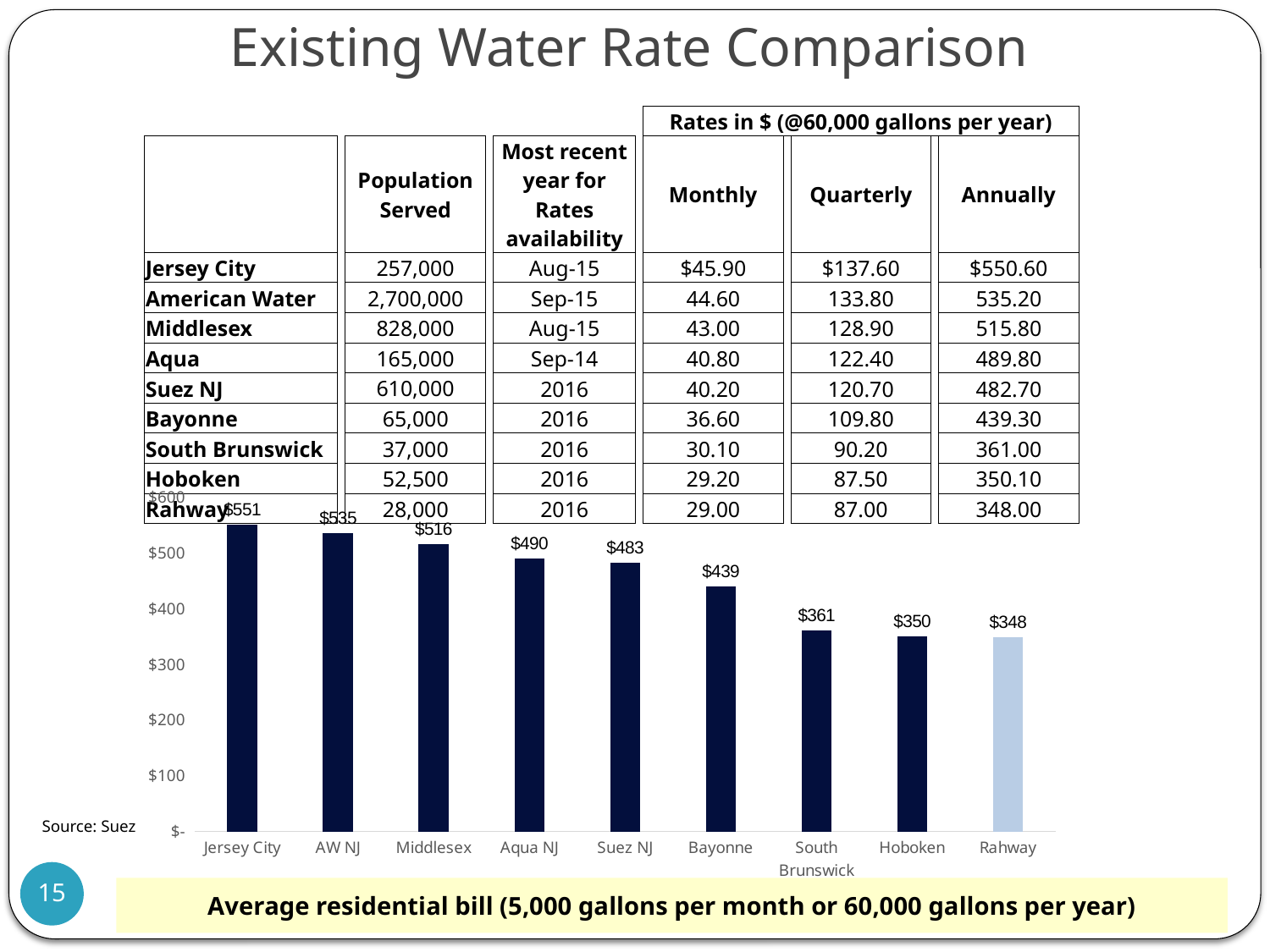
Is the value for Hoboken in the chart greater or less than $400? less What is the difference between the values for Middlesex and Aqua NJ in the chart? $26 What is the value of the bar for South Brunswick in the chart? $361 What is the value of the bar for Jersey City in the chart? $551 Which category has the lowest bar in the chart? Rahway Which is larger in the chart, the value for Suez NJ or the value for Bayonne? Suez NJ What is the difference between the values for Jersey City and Rahway in the chart? $203 How many categories are shown on the x axis of the chart? 9 What is the value of the bar for Bayonne in the chart? $439 What kind of chart is shown on the slide? bar chart Which category has the highest bar in the chart? Jersey City Do the bar values rise or fall from left to right along the x axis of the chart? fall